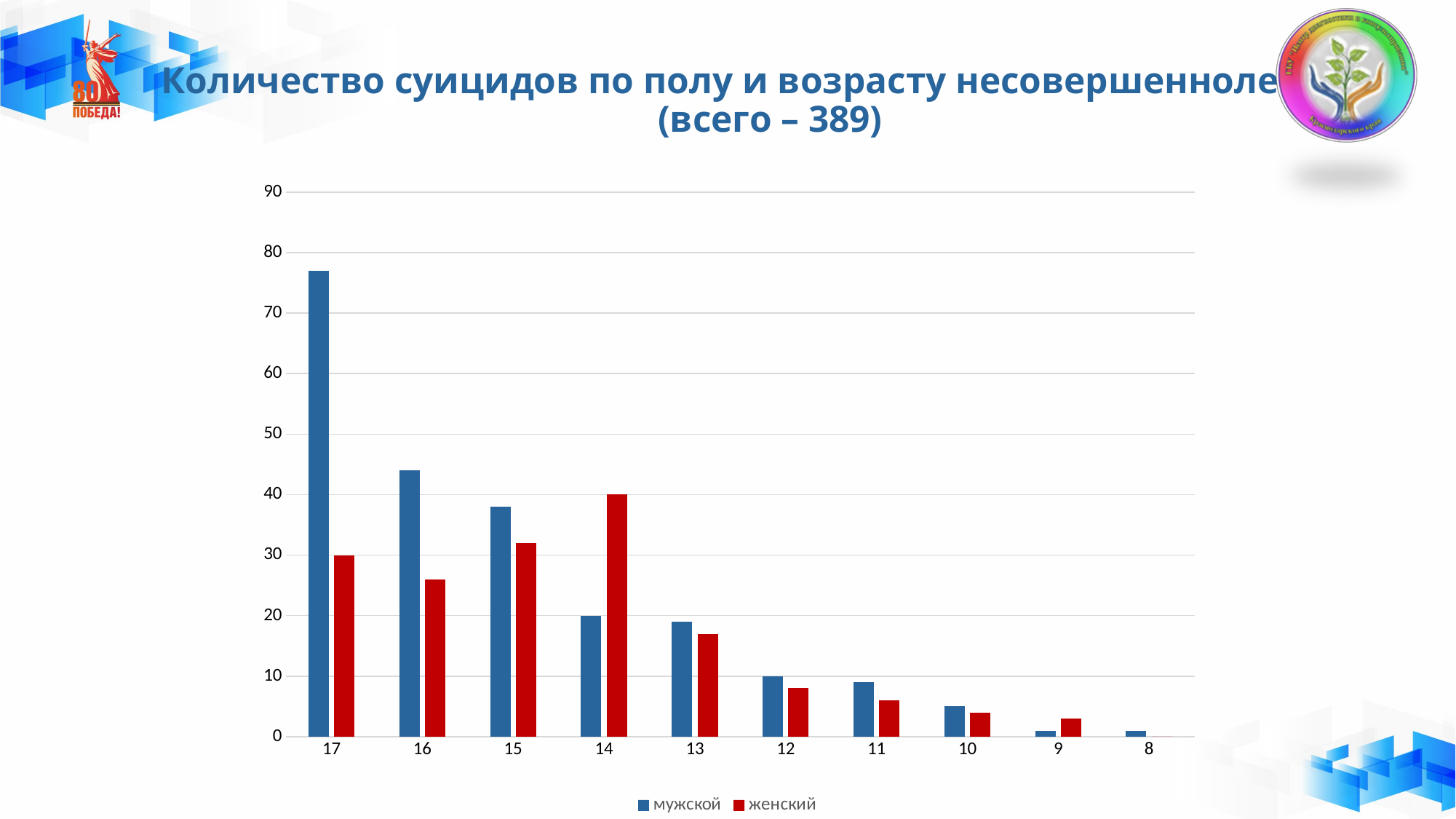
For which age is the женский (female) value highest? 14 What kind of chart is shown on the slide? bar chart For which age is the мужской (male) value highest? 17 How many age categories are shown on the x axis? 10 At age 14, which series has the larger value, мужской or женский? женский Is the мужской value for age 16 greater or less than 40? greater Do the мужской values rise or fall as the x axis goes from 17 to 8? fall Is the мужской value for age 17 greater or less than 70? greater At age 17, which series has the larger value, мужской or женский? мужской What total number is given in parentheses in the chart title? 389 Is the женский value for age 16 greater or less than 30? less How many series does the legend list? 2